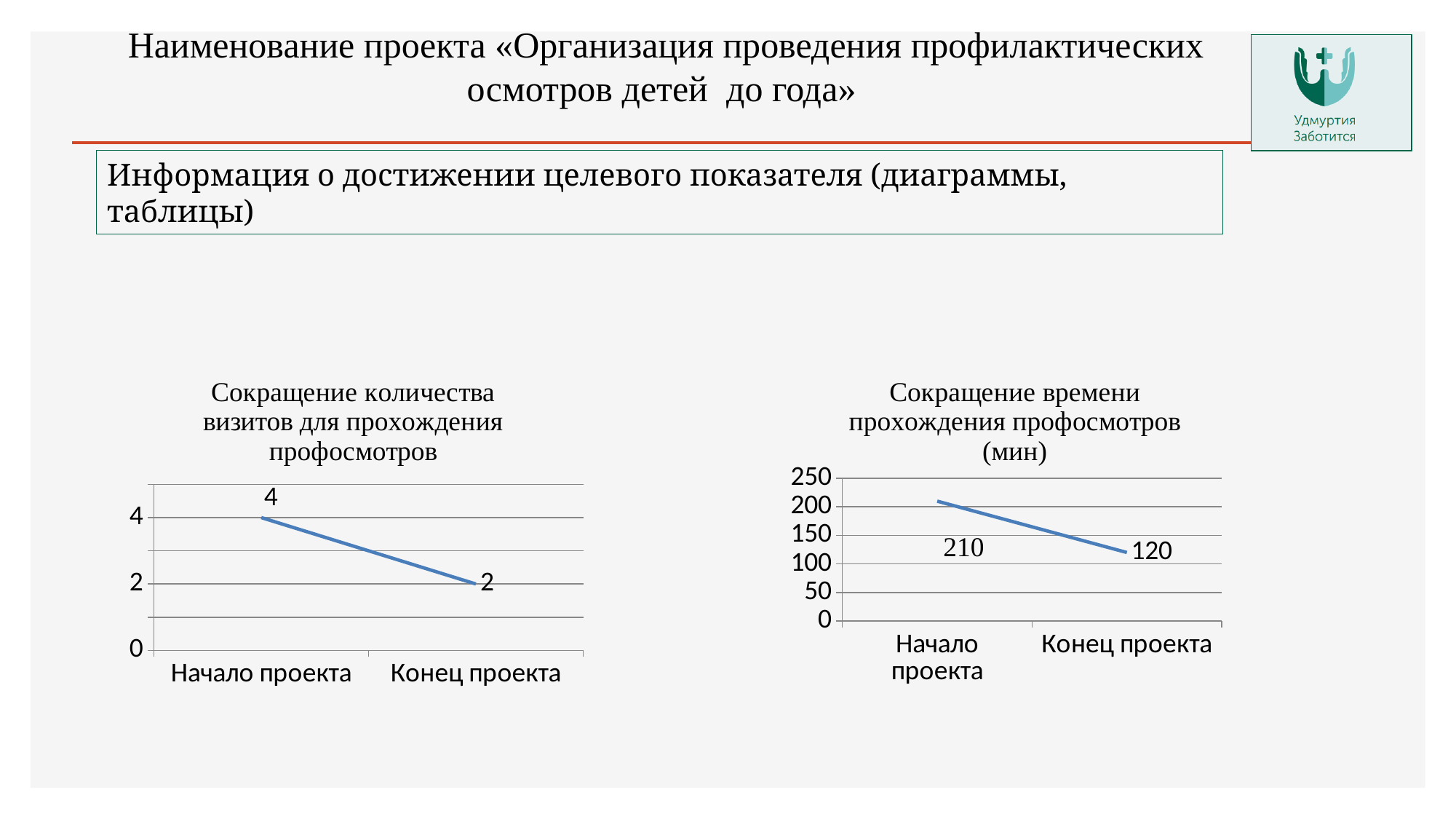
What kind of chart is the right chart 'Сокращение времени прохождения профосмотров (мин)'? line chart In the right chart 'Сокращение времени прохождения профосмотров (мин)', what is the value for 'Конец проекта'? 120 In the right chart 'Сокращение времени прохождения профосмотров (мин)', which category has the higher value? Начало проекта In the right chart 'Сокращение времени прохождения профосмотров (мин)', what is the difference between the values for 'Начало проекта' and 'Конец проекта'? 90 In the left chart 'Сокращение количества визитов для прохождения профосмотров', what is the difference between the values for 'Начало проекта' and 'Конец проекта'? 2 How many categories are shown on the x axis of the right chart 'Сокращение времени прохождения профосмотров (мин)'? 2 In the left chart 'Сокращение количества визитов для прохождения профосмотров', what is the value for 'Конец проекта'? 2 In the left chart 'Сокращение количества визитов для прохождения профосмотров', what is the value for 'Начало проекта'? 4 In the right chart 'Сокращение времени прохождения профосмотров (мин)', what is the value for 'Начало проекта'? 210 In the right chart 'Сокращение времени прохождения профосмотров (мин)', is the value for 'Конец проекта' greater or less than 150? less In the left chart 'Сокращение количества визитов для прохождения профосмотров', do the values rise or fall from 'Начало проекта' to 'Конец проекта'? fall In the left chart 'Сокращение количества визитов для прохождения профосмотров', which category has the lowest value? Конец проекта